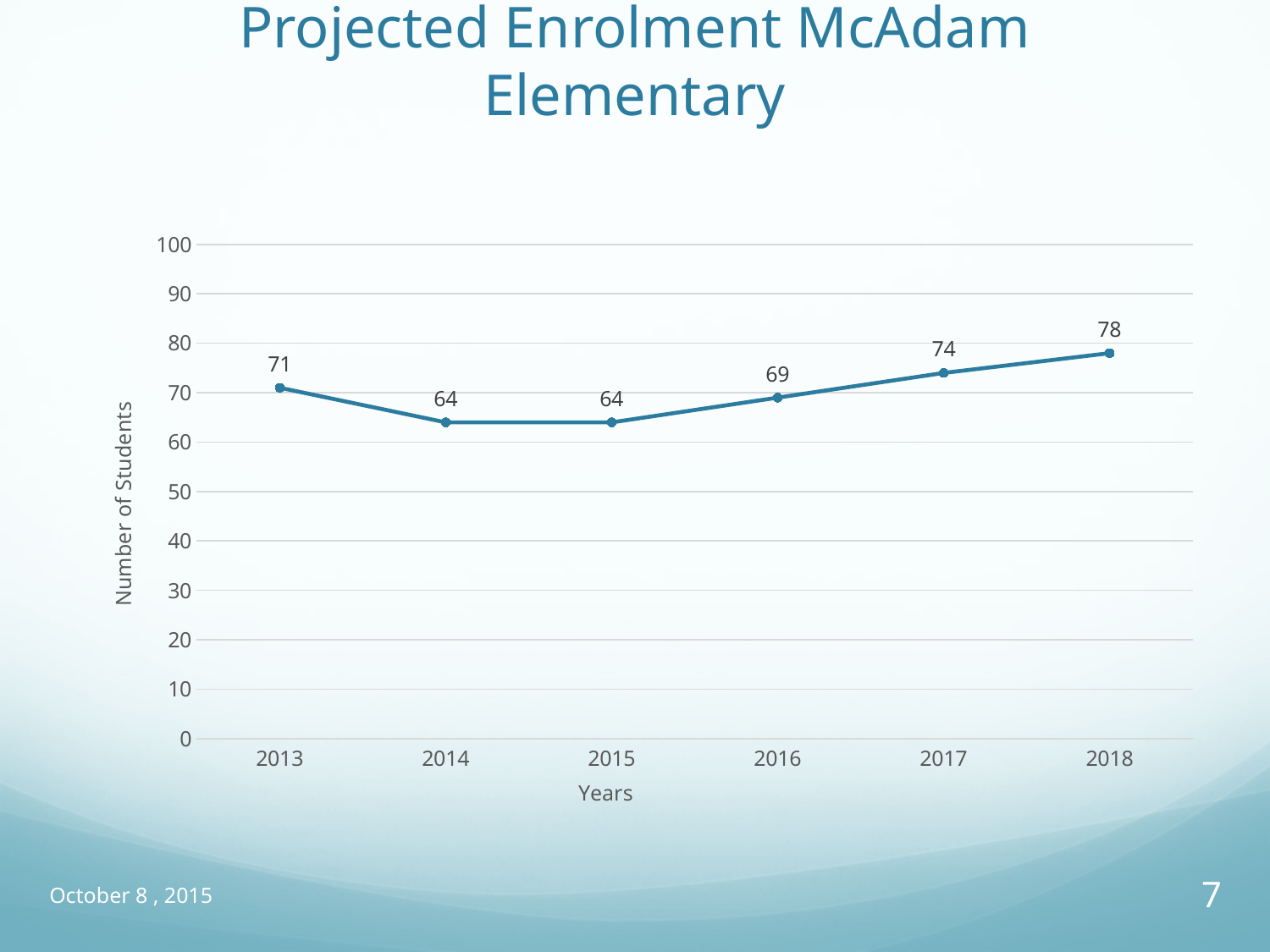
What is the projected enrolment for 2018? 78 What is the projected enrolment for 2016? 69 Do the values rise or fall from 2015 to 2018? Rise Is the value for 2017 greater or less than 70? greater What kind of chart is shown on the slide? Line chart What is the difference between the projected enrolment in 2018 and in 2014? 14 Which year has a larger projected enrolment, 2013 or 2017? 2017 How many years are shown on the x axis? 6 What is the lowest value plotted on the chart? 64 What is the label of the y axis? Number of Students What is the projected enrolment for 2013? 71 Which year has the highest projected enrolment? 2018